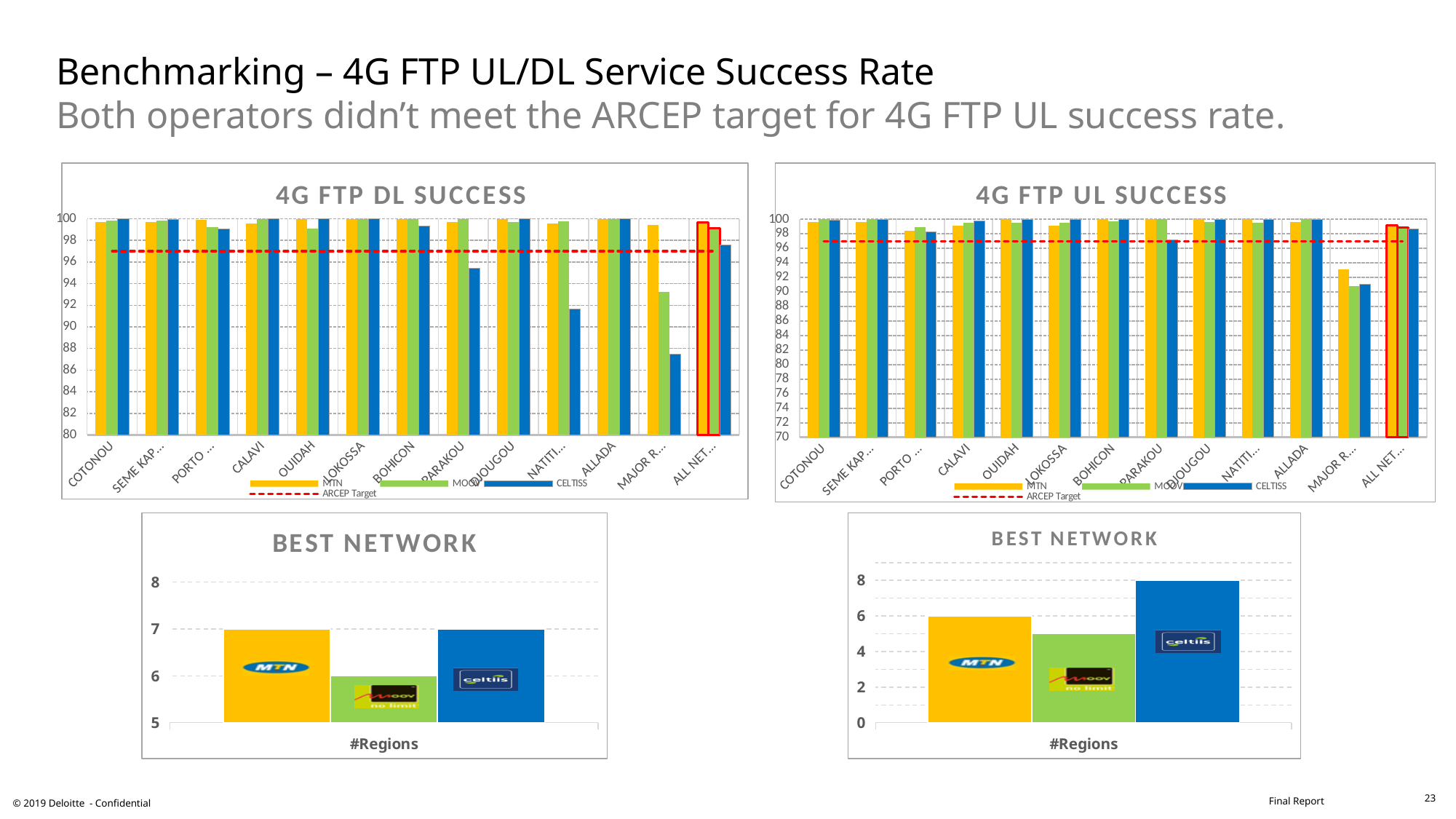
What kind of chart is the 4G FTP UL SUCCESS chart? combination bar and line chart On the 4G FTP DL SUCCESS chart, is the CELTIIS value for NATITI... greater or less than 94? less On the 4G FTP UL SUCCESS chart, how many categories are shown on the x axis? 13 On the bottom-right BEST NETWORK chart, which operator has the highest value? CELTIIS On the 4G FTP UL SUCCESS chart, is the MTN value for MAJOR R... greater or less than 90? greater On the bottom-right BEST NETWORK chart, what is the value for CELTIIS? 8 On the bottom-right BEST NETWORK chart, what is the difference between the CELTIIS value and the MTN value? 2 On the 4G FTP DL SUCCESS chart, how many series does the legend list? 4 On the 4G FTP DL SUCCESS chart, is the CELTIIS value for MAJOR R... greater or less than 90? less On the bottom-left BEST NETWORK chart, which operator has the lowest value? MOOV On the bottom-left BEST NETWORK chart, what is the value for MOOV? 6 On the 4G FTP DL SUCCESS chart, which series is drawn as a red dashed line? ARCEP Target